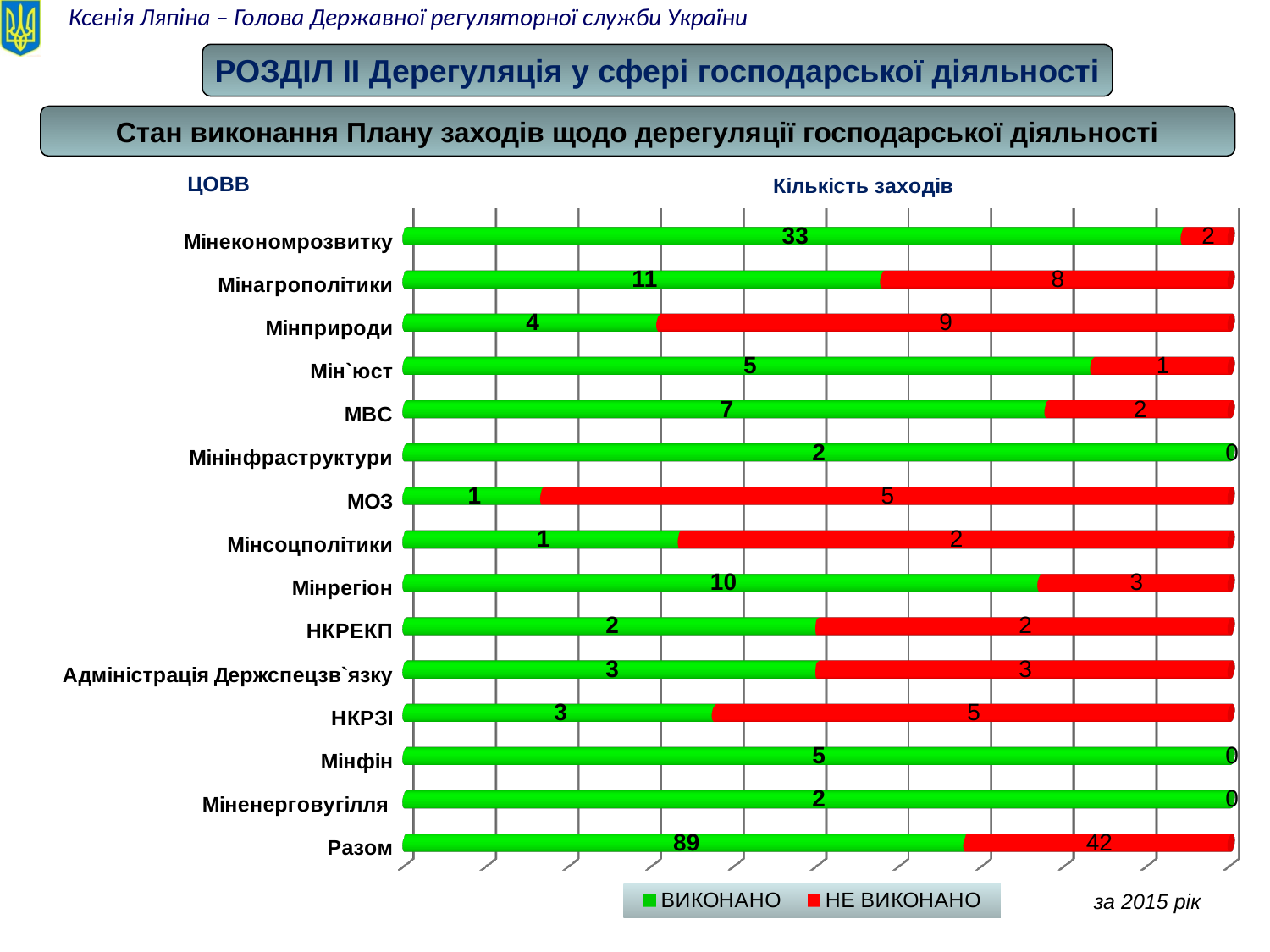
Excluding the Разом bar, which category has the highest НЕ ВИКОНАНО value? Мінприроди What is the ВИКОНАНО value for the Разом bar? 89 What is the ВИКОНАНО value for Мінекономрозвитку? 33 What kind of chart is shown on the slide? Stacked bar chart Excluding the Разом bar, which category has the highest ВИКОНАНО value? Мінекономрозвитку What is the difference between the НЕ ВИКОНАНО and ВИКОНАНО values for Мінприроди? 5 What is the total of the Мінагрополітики bar (ВИКОНАНО plus НЕ ВИКОНАНО)? 19 What is the НЕ ВИКОНАНО value for Мінприроди? 9 Which is larger, the ВИКОНАНО value for Мінрегіон or the ВИКОНАНО value for МВС? Мінрегіон How many series does the legend list? 2 What is the НЕ ВИКОНАНО value for МОЗ? 5 How many categories are shown on the vertical axis of the chart? 15